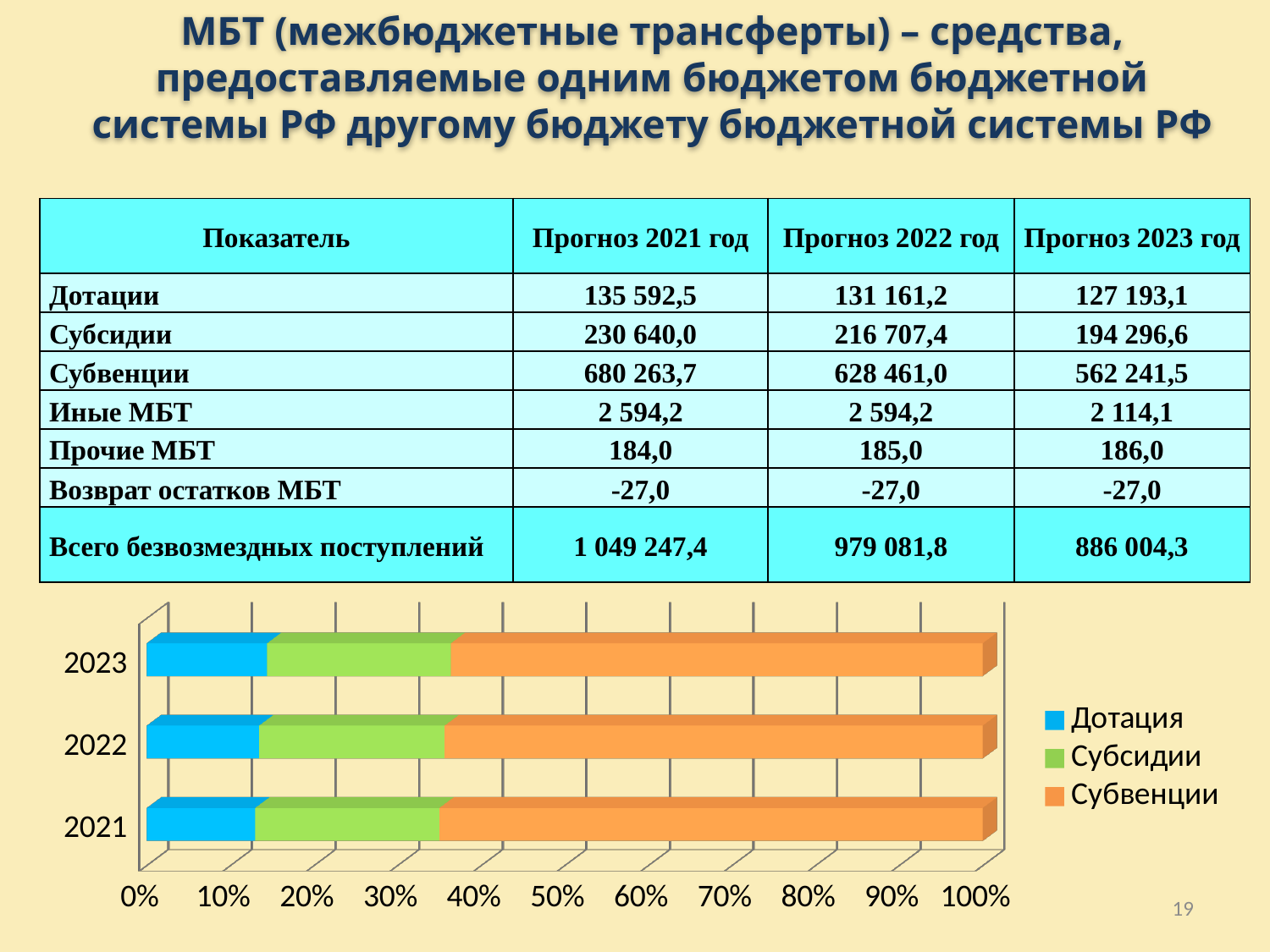
In the chart, which series takes the largest share of the 2021 bar? Субвенции In the 2022 bar of the chart, which share is larger: Субсидии or Дотация? Субсидии Which series is shown in blue in the chart legend? Дотация In the chart, is the share of Субвенции in the 2022 bar greater or less than 50%? greater In the chart, is the share of Субсидии in the 2023 bar greater or less than 30%? less In the chart, which series takes the smallest share of the 2023 bar? Дотация What is the highest value shown on the chart's horizontal axis? 100% What kind of chart is shown at the bottom of the slide? bar chart How many years (bars) are shown on the chart? 3 In the chart, is the share of Дотация in the 2021 bar greater or less than 20%? less How many series does the chart legend list? 3 Which series is shown in orange in the chart legend? Субвенции